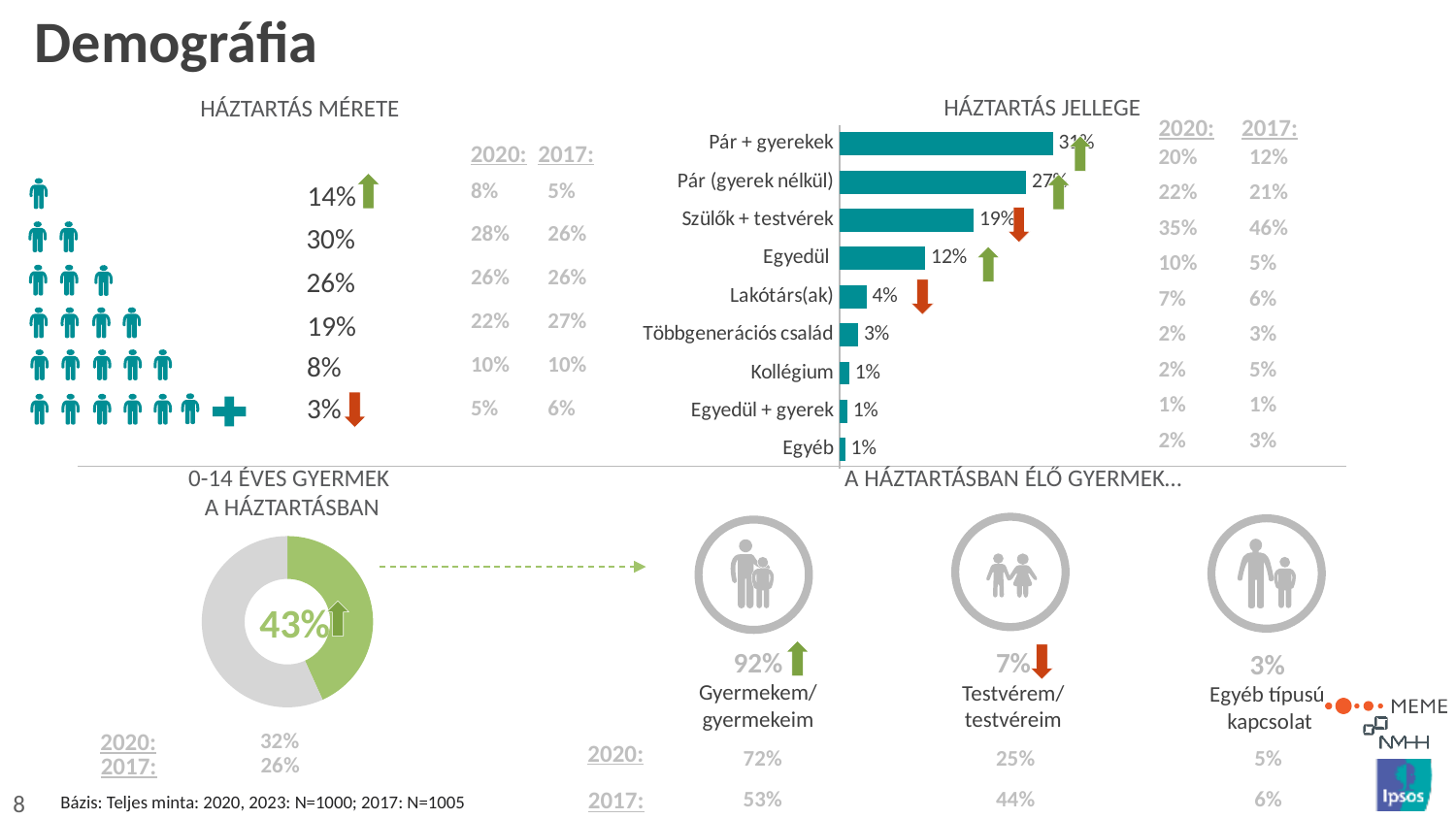
In the HÁZTARTÁS JELLEGE chart, what is the value for Pár (gyerek nélkül)? 27% How many categories are shown in the HÁZTARTÁS JELLEGE chart? 9 In the HÁZTARTÁS MÉRETE chart, what is the highest percentage shown? 30% In the HÁZTARTÁS JELLEGE chart, what is the value for Egyedül? 12% In the HÁZTARTÁS JELLEGE chart, what is the value for Lakótárs(ak)? 4% In the HÁZTARTÁS JELLEGE chart, what is the value for Többgenerációs család? 3% In the HÁZTARTÁS JELLEGE chart, what is the difference between Pár (gyerek nélkül) and Egyedül? 15% In the HÁZTARTÁS JELLEGE chart, which is larger: Szülők + testvérek or Lakótárs(ak)? Szülők + testvérek What percentage is shown in the 0-14 ÉVES GYERMEK A HÁZTARTÁSBAN donut chart? 43% In the HÁZTARTÁS JELLEGE chart, which category has the highest value? Pár + gyerekek What kind of chart is the HÁZTARTÁS JELLEGE chart? Bar chart In the HÁZTARTÁS JELLEGE chart, what is the value for Szülők + testvérek? 19%